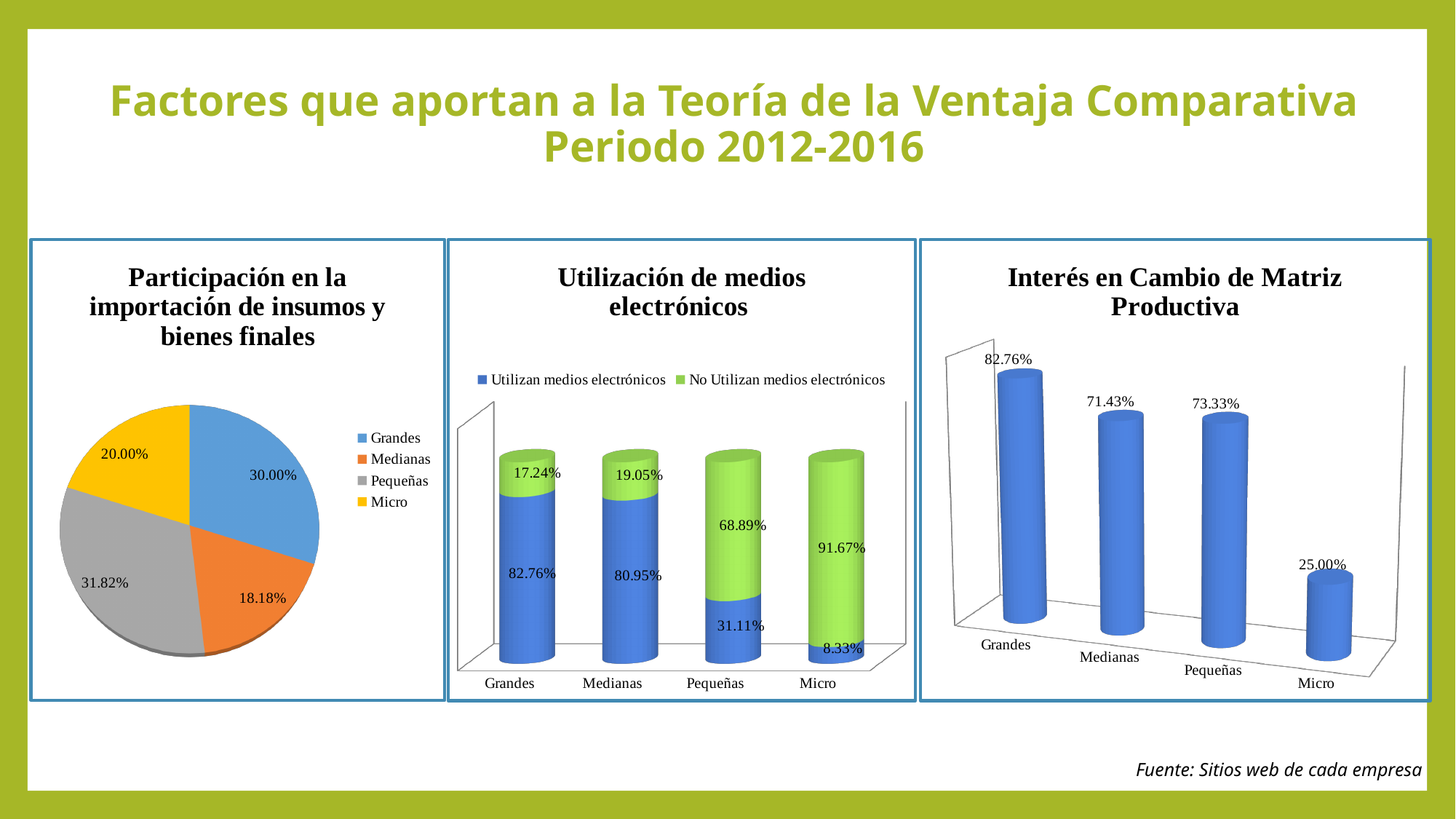
In the 'Utilización de medios electrónicos' chart, which category has the highest value for 'Utilizan medios electrónicos'? Grandes In the 'Participación en la importación de insumos y bienes finales' chart, which category has the smallest slice? Medianas In the 'Participación en la importación de insumos y bienes finales' chart, how many categories does the legend list? 4 In the 'Participación en la importación de insumos y bienes finales' chart, what is the share for Pequeñas? 31.82% In the 'Utilización de medios electrónicos' chart, what is the difference between 'No Utilizan medios electrónicos' for Pequeñas and for Grandes? 51.65% In the 'Interés en Cambio de Matriz Productiva' chart, what is the value for Micro? 25.00% In the 'Utilización de medios electrónicos' chart, what is the value of 'Utilizan medios electrónicos' for Medianas? 80.95% In the 'Utilización de medios electrónicos' chart, how many series does the legend list? 2 In the 'Utilización de medios electrónicos' chart, what is the value of 'No Utilizan medios electrónicos' for Micro? 91.67% In the 'Interés en Cambio de Matriz Productiva' chart, what is the difference between Grandes and Medianas? 11.33% What kind of chart is 'Participación en la importación de insumos y bienes finales'? Pie chart In the 'Interés en Cambio de Matriz Productiva' chart, which category has the highest value? Grandes